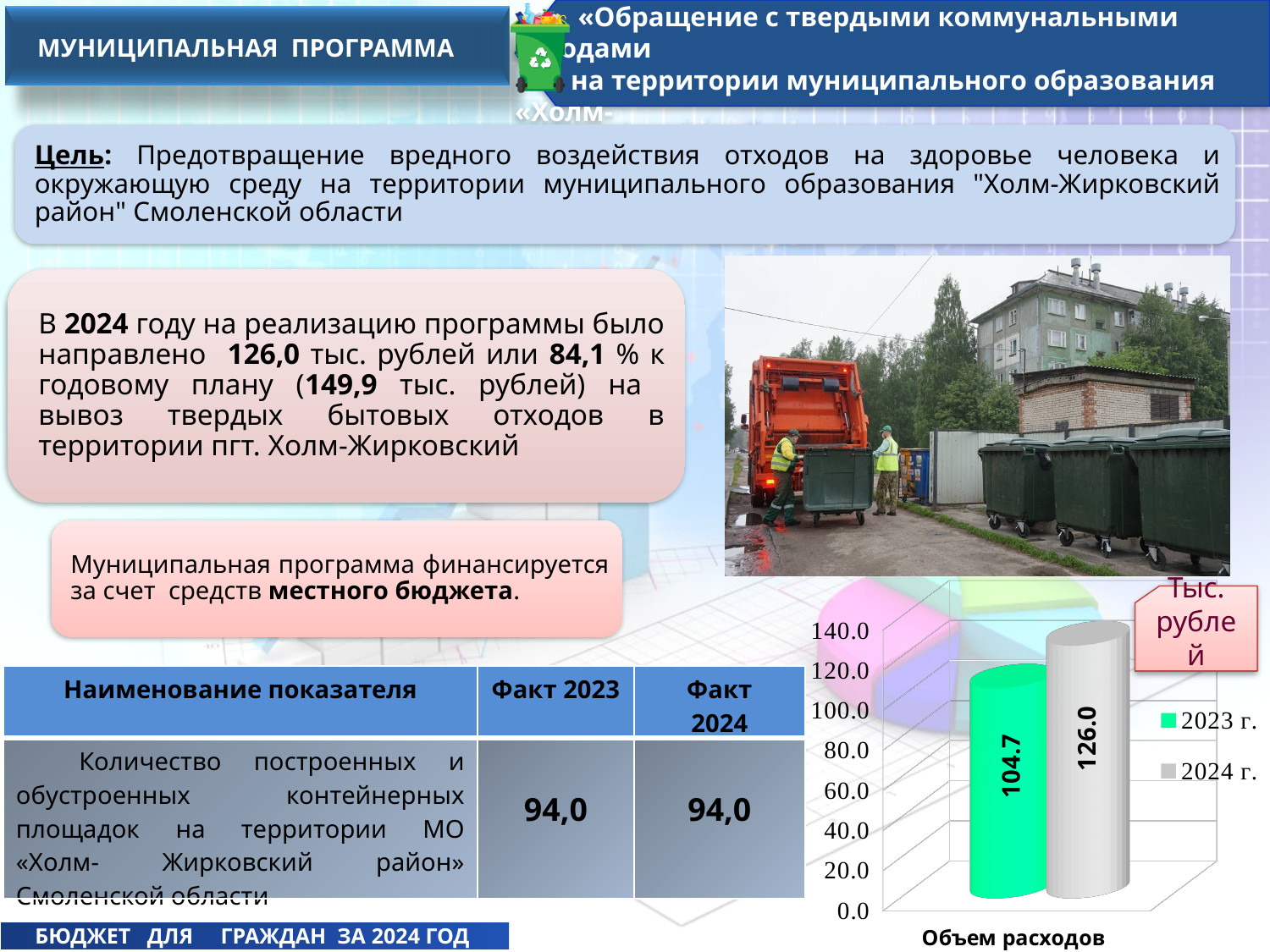
What kind of chart is shown on the slide? bar chart What is the value for 2024 г. in the chart? 126.0 Is the value for 2023 г. greater or less than 100.0? greater How many series does the chart legend list? 2 What is the maximum value shown on the chart's vertical axis? 140.0 Which series has the higher value in the chart, 2023 г. or 2024 г.? 2024 г. What is the category label shown under the bars in the chart? Объем расходов What is the value for 2023 г. in the chart? 104.7 What is the difference between the 2024 г. and 2023 г. values in the chart? 21.3 Do the values rise or fall from 2023 г. to 2024 г. in the chart? rise Which series has the lowest value in the chart? 2023 г. Is the value for 2024 г. greater or less than 140.0? less